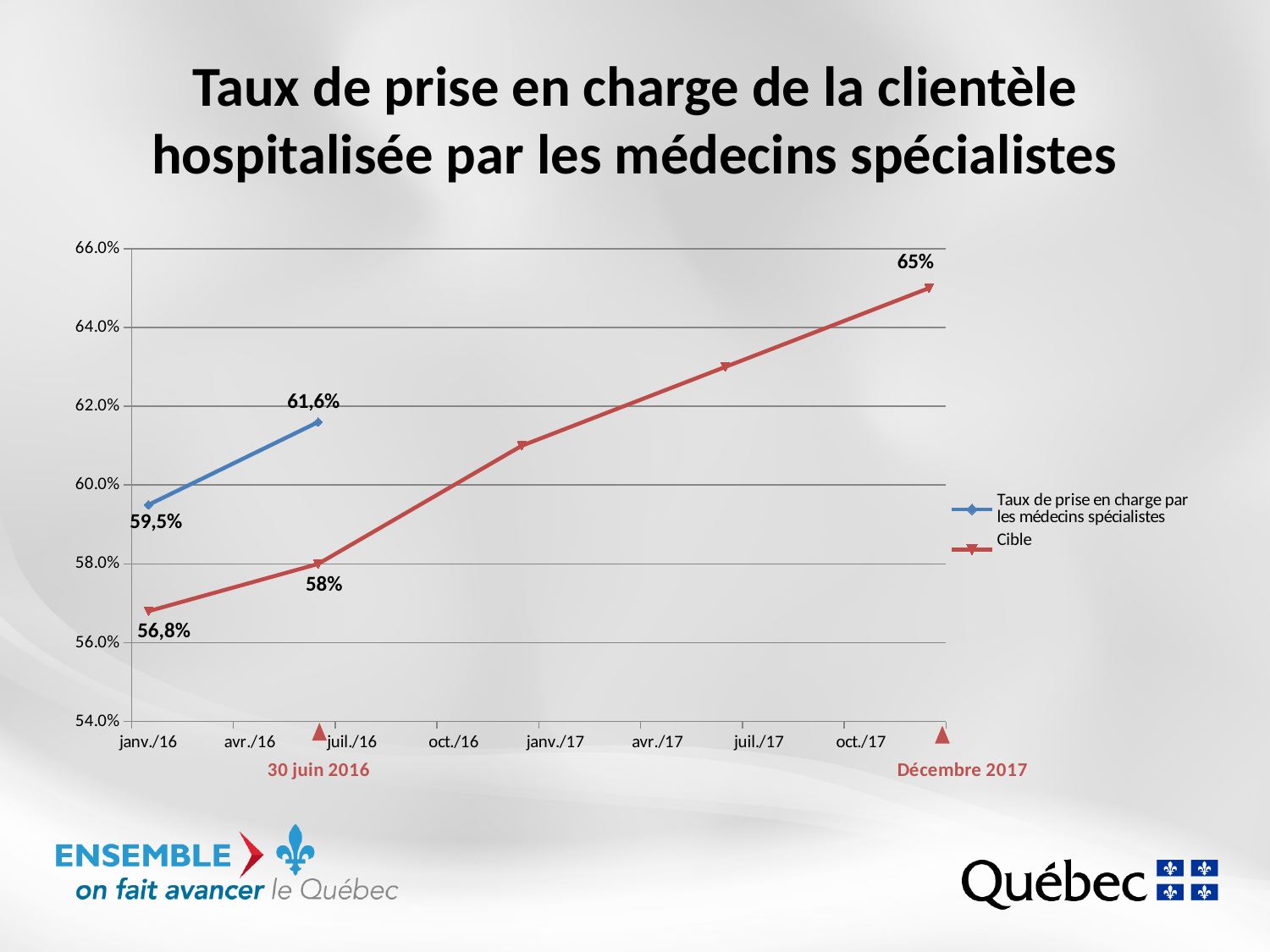
What is the value of the 'Taux de prise en charge par les médecins spécialistes' series at janv./16? 59,5% What kind of chart is shown on the slide? line chart Is the 'Cible' value at juil./17 greater or less than 64.0%? less What is the value of the 'Cible' series at janv./16? 56,8% How many series does the legend list? 2 Does the 'Cible' series rise or fall from janv./16 to Décembre 2017? rise Is the 'Cible' value at janv./17 greater or less than 60.0%? greater What is the value of the 'Cible' series at 30 juin 2016? 58% What is the value of the 'Taux de prise en charge par les médecins spécialistes' series at 30 juin 2016? 61,6% What is the final 'Cible' value shown for Décembre 2017? 65% Which series has the higher value at janv./16, 'Taux de prise en charge par les médecins spécialistes' or 'Cible'? Taux de prise en charge par les médecins spécialistes What is the title of the chart? Taux de prise en charge de la clientèle hospitalisée par les médecins spécialistes